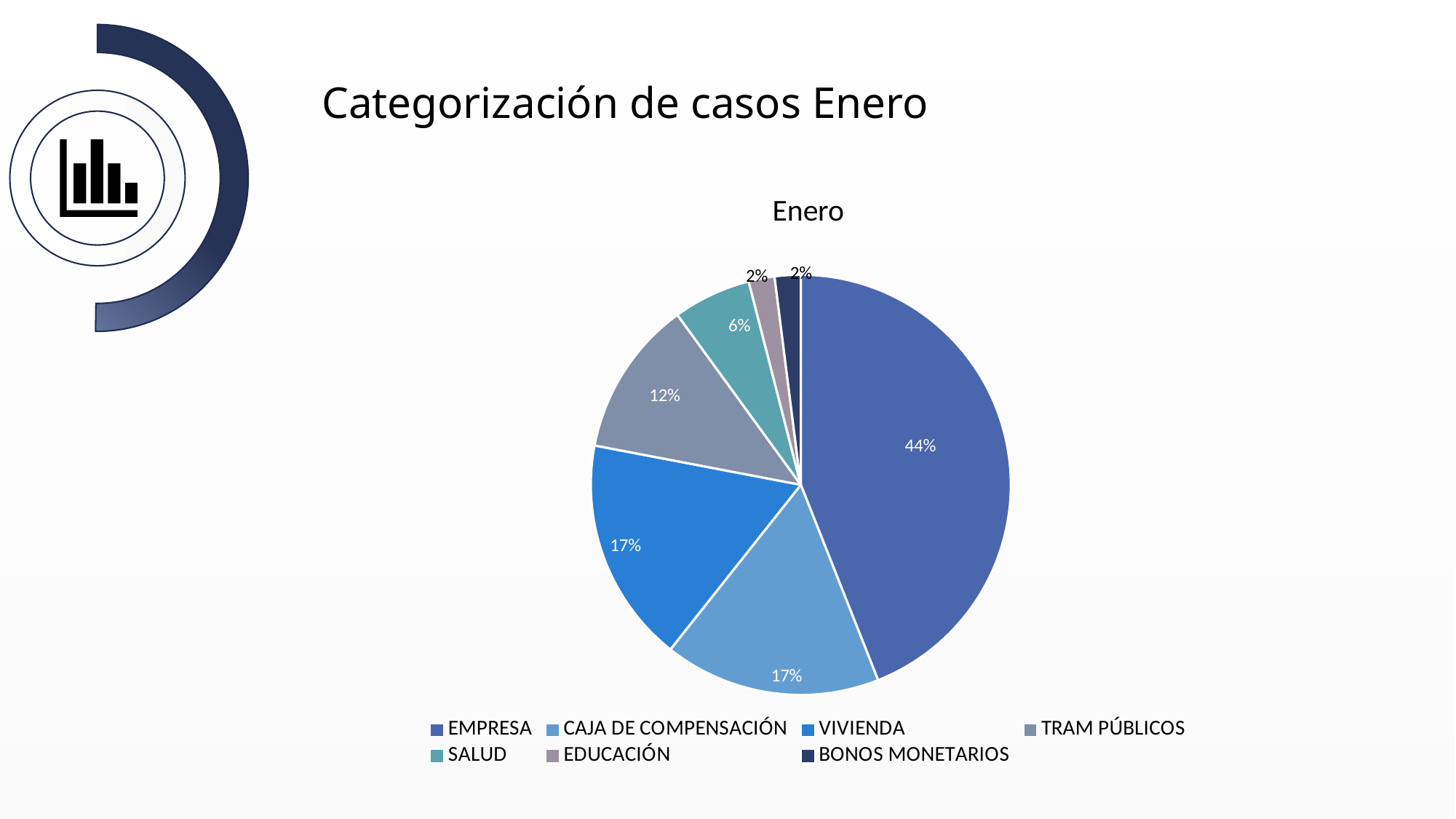
How many categories does the pie chart show? 7 What percentage is shown for EDUCACIÓN? 2% What percentage is shown for TRAM PÚBLICOS? 12% What percentage is shown for SALUD? 6% Which category has the largest slice of the pie? EMPRESA Which is larger, the slice for VIVIENDA or the slice for TRAM PÚBLICOS? VIVIENDA What is the difference in percentage points between TRAM PÚBLICOS and SALUD? 6 What is the difference in percentage points between EMPRESA and CAJA DE COMPENSACIÓN? 27 What share of the pie does EMPRESA represent? 44% What percentage is shown for VIVIENDA? 17% What type of chart is shown on the slide? Pie chart What is the title of the chart? Enero